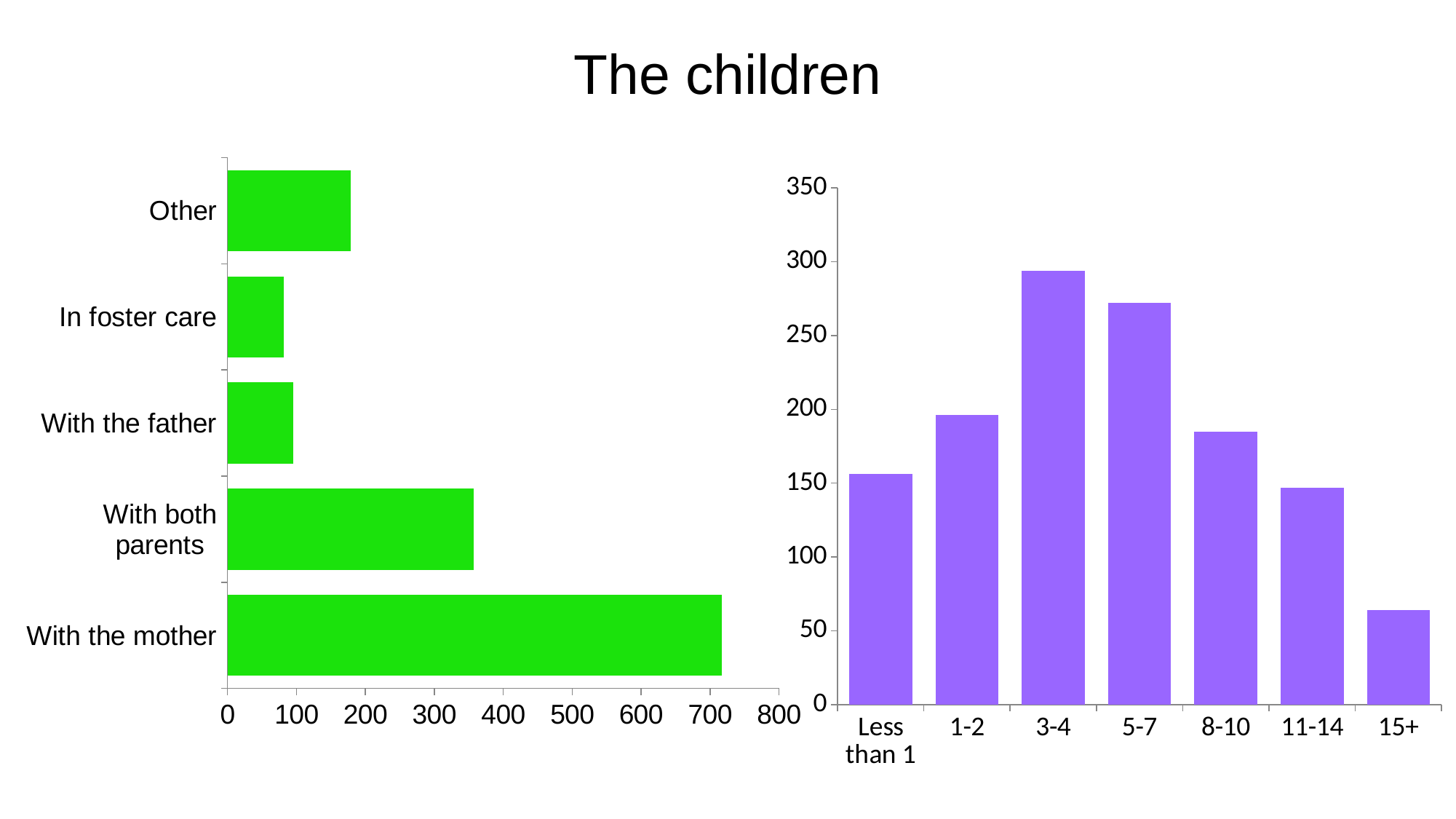
On the right chart, which category has the highest value? 3-4 What kind of chart is the left chart? bar chart On the left chart, is the value for With the mother greater or less than 700? greater On the right chart, is the value for 15+ greater or less than 100? less On the left chart, is the value for Other greater or less than 200? less How many categories are shown on the right chart? 7 How many categories are shown on the left chart? 5 On the right chart, which category has the lowest value? 15+ On the left chart, which is larger, the value for Other or the value for In foster care? Other On the left chart, which category has the highest value? With the mother